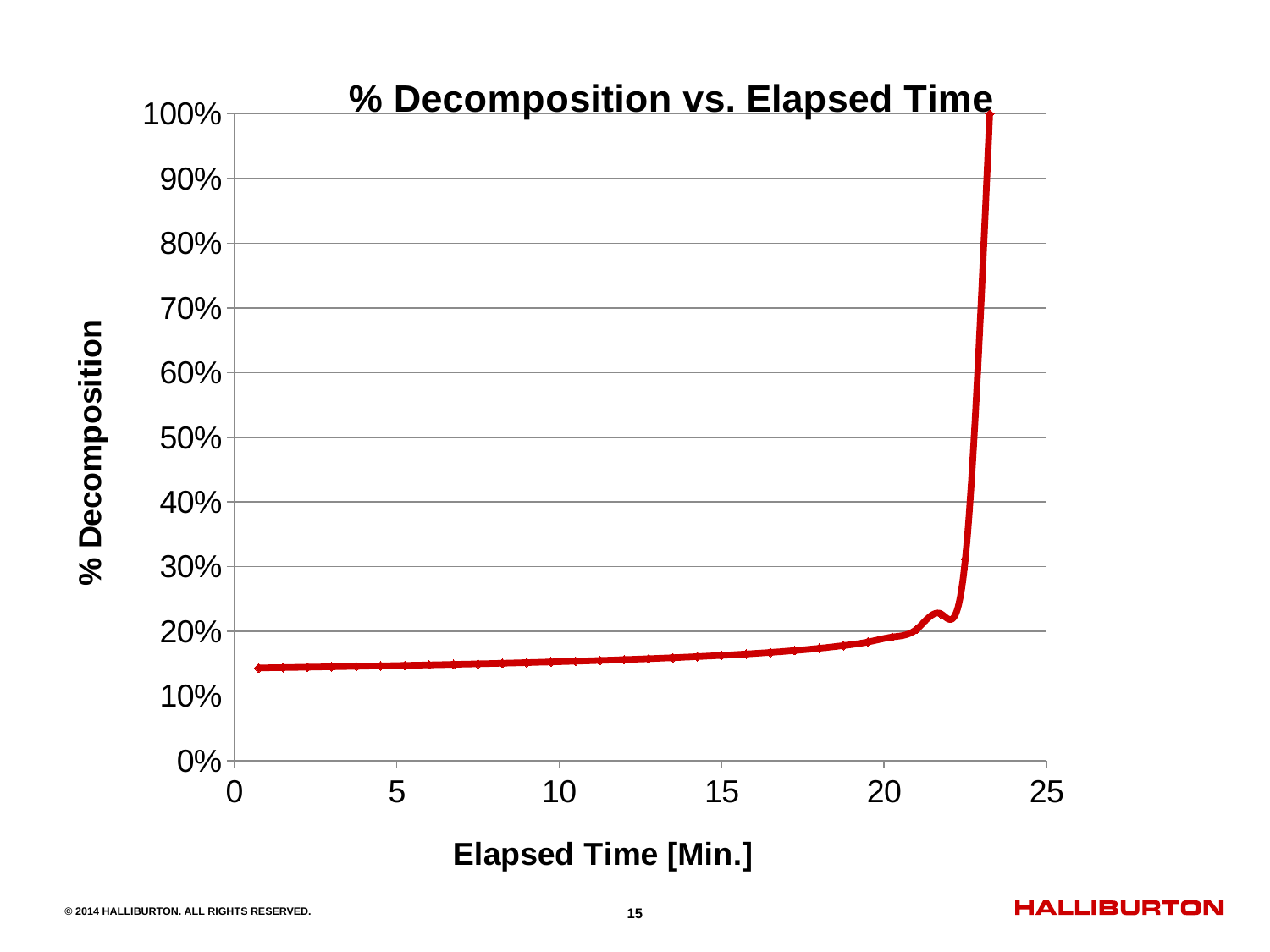
Does the % Decomposition rise or fall as elapsed time increases? rise Is the % Decomposition at 10 minutes greater or less than 20%? less Is the % Decomposition at 1 minute greater or less than 20%? less Is the % Decomposition higher at 20 minutes or at 5 minutes? 20 minutes Is the % Decomposition higher at 10 minutes or at 22 minutes? 22 minutes How many data series are plotted on the chart? 1 Is the % Decomposition at 20 minutes greater or less than 30%? less What kind of chart is shown on the slide? line chart What is the title of the chart? % Decomposition vs. Elapsed Time What is the label of the x axis? Elapsed Time [Min.]